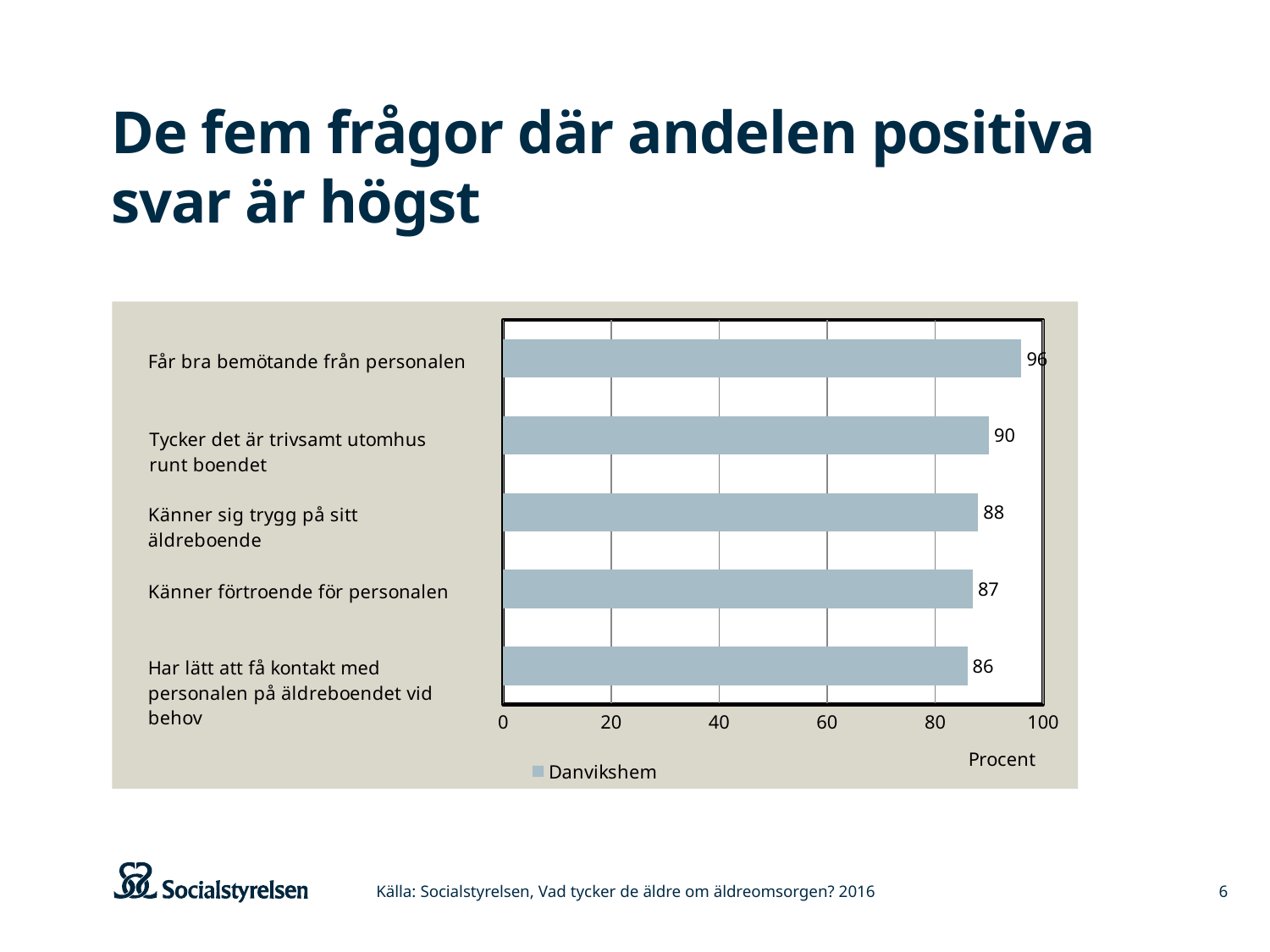
How many categories are shown in the chart? 5 What is the difference between the values for "Får bra bemötande från personalen" and "Tycker det är trivsamt utomhus runt boendet"? 6 Which category has the highest value? Får bra bemötande från personalen How many series does the legend list? 1 What is the value for "Känner sig trygg på sitt äldreboende"? 88 What kind of chart is shown on the slide? bar chart What is the value for "Får bra bemötande från personalen"? 96 What is the value for "Har lätt att få kontakt med personalen på äldreboendet vid behov"? 86 Which is larger: the value for "Känner förtroende för personalen" or the value for "Tycker det är trivsamt utomhus runt boendet"? Tycker det är trivsamt utomhus runt boendet Is the value for "Känner förtroende för personalen" greater or less than 80? greater Which category has the lowest value? Har lätt att få kontakt med personalen på äldreboendet vid behov What is the name of the series shown in the legend? Danvikshem